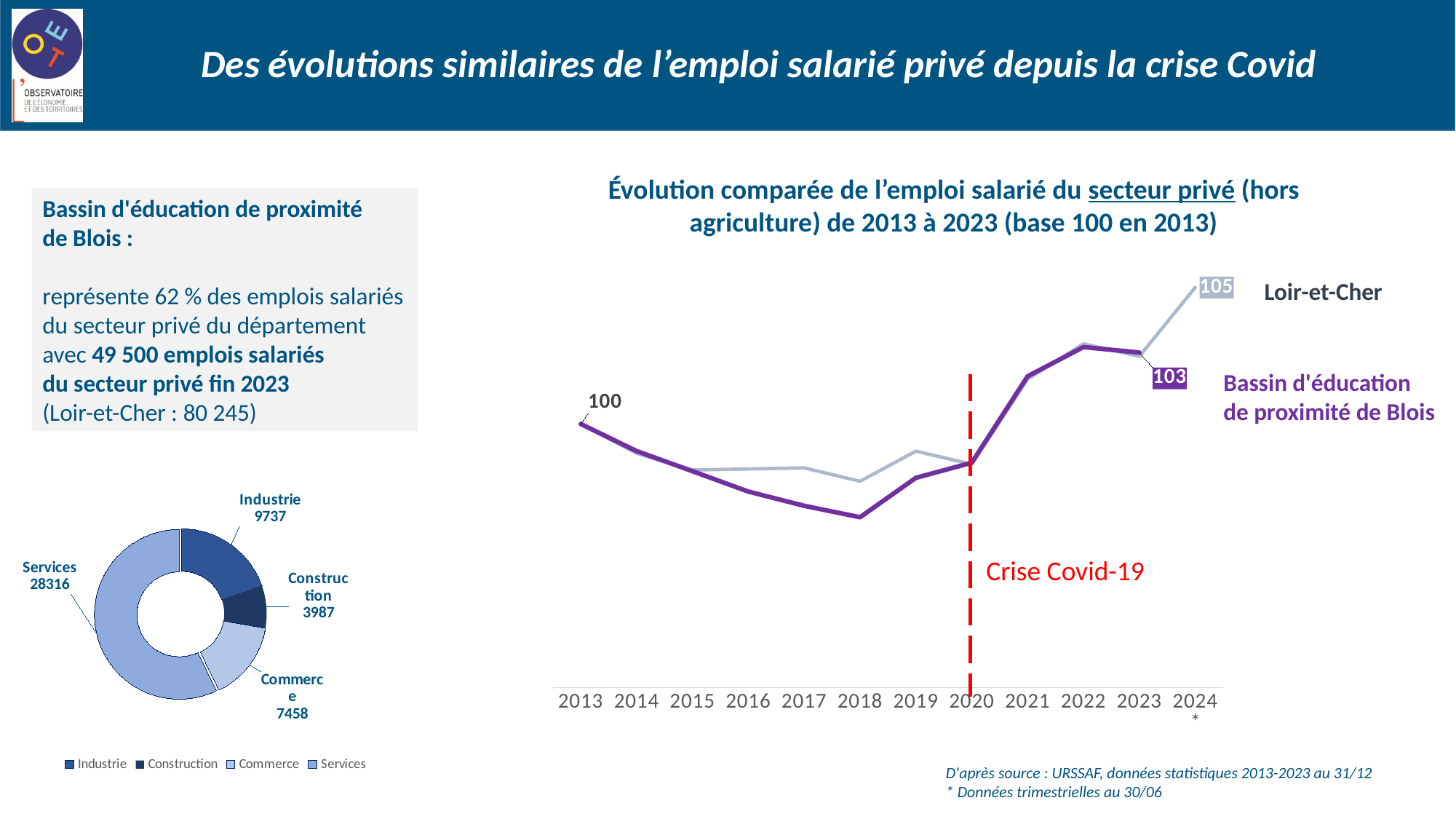
In the doughnut chart on the left, how many categories does the legend list? 4 In the line chart on the right, what is the value for Loir-et-Cher in 2024? 105 In the line chart on the right, does the Bassin d'éducation de proximité de Blois series rise or fall between 2013 and 2018? Fall In the line chart on the right, how many series are plotted? 2 What type of chart is the chart titled 'Évolution comparée de l'emploi salarié du secteur privé'? Line chart In the doughnut chart on the left, what is the difference between the values for Industrie and Commerce? 2279 In the doughnut chart on the left, what is the value for Construction? 3987 What type of chart is the chart on the left of the slide? Doughnut chart In the line chart on the right, what is the value for Bassin d'éducation de proximité de Blois in 2023? 103 In the doughnut chart on the left, which category has the smallest value? Construction In the doughnut chart on the left, what is the value for Services? 28316 In the doughnut chart on the left, which category has the largest value? Services